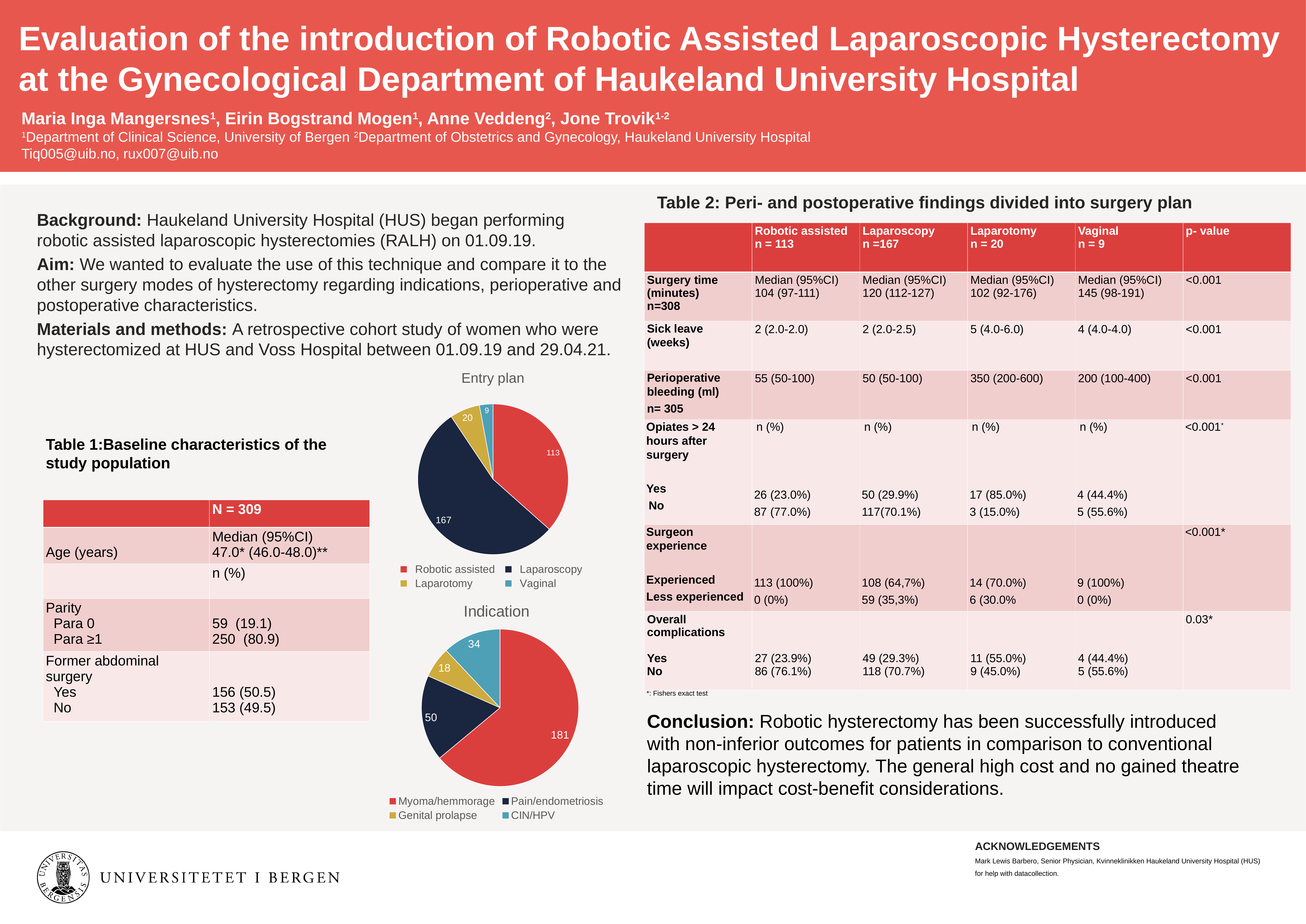
In the "Indication" chart, what is the value for Pain/endometriosis? 50 In the "Entry plan" chart, how many categories does the legend list? 4 In the "Entry plan" chart, what is the difference between the Laparoscopy and Robotic assisted values? 54 In the "Entry plan" chart, which category has the smallest slice? Vaginal In the "Indication" chart, which is larger, Genital prolapse or CIN/HPV? CIN/HPV In the "Entry plan" chart, which category has the largest slice? Laparoscopy In the "Entry plan" chart, what is the value for Laparoscopy? 167 In the "Indication" chart, what is the difference between the Myoma/hemmorage and Pain/endometriosis values? 131 In the "Indication" chart, which category has the largest slice? Myoma/hemmorage In the "Indication" chart, what is the value for CIN/HPV? 34 In the "Entry plan" chart, what is the value for Robotic assisted? 113 What type of chart is the "Indication" chart? Pie chart